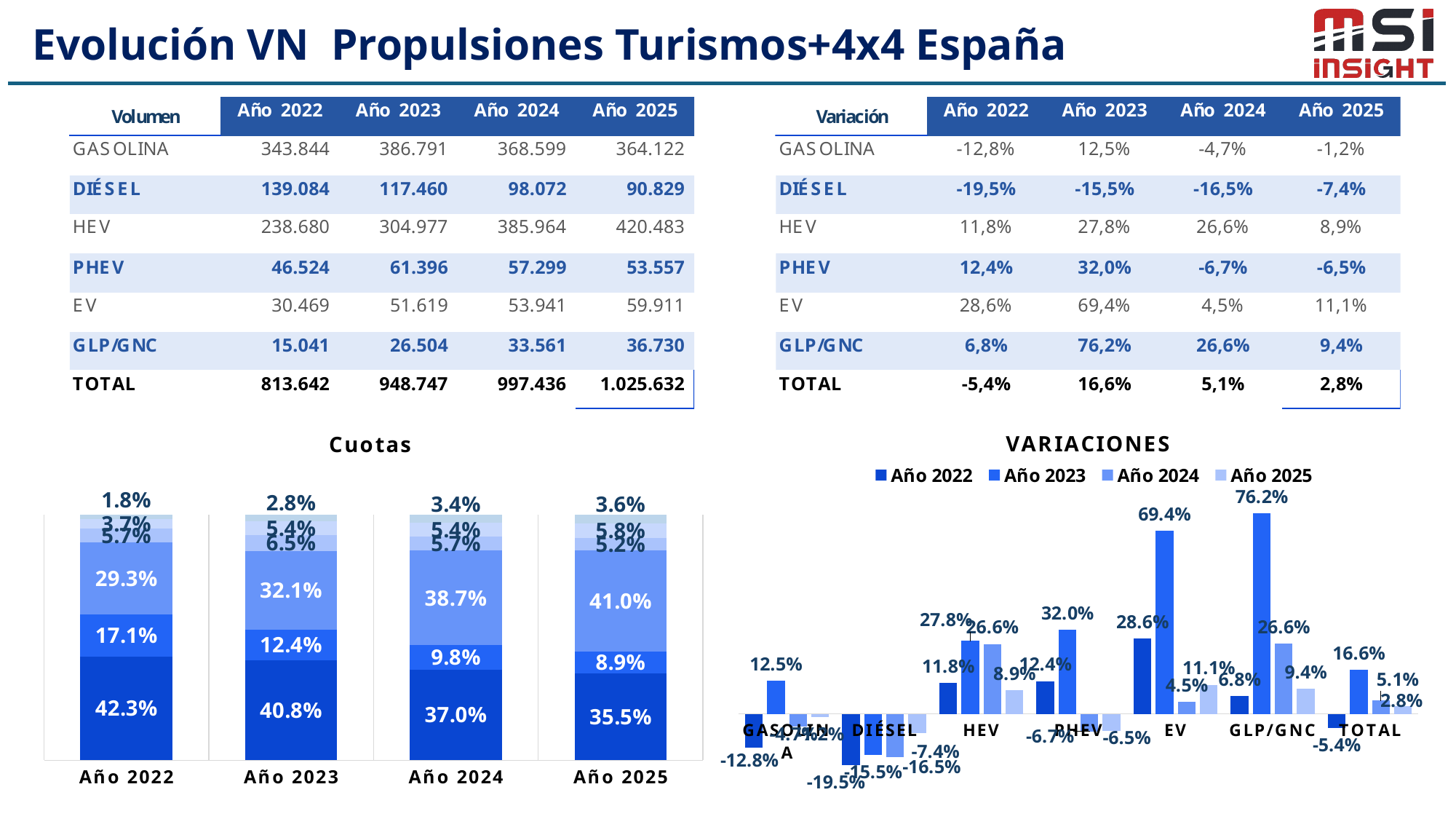
In the Cuotas chart, what is the value of the bottom segment of the Año 2025 bar? 35.5% What kind of chart is the VARIACIONES chart? Bar chart In the VARIACIONES chart, what is the value for GLP/GNC in Año 2023? 76.2% In the Cuotas chart, does the bottom segment of the bars rise or fall from Año 2022 to Año 2025? Fall In the Cuotas chart, what is the difference between the bottom segment of the Año 2022 bar and the bottom segment of the Año 2025 bar? 6.8 percentage points How many categories are shown on the x axis of the VARIACIONES chart? 7 In the VARIACIONES chart, which is larger: EV in Año 2023 or GLP/GNC in Año 2023? GLP/GNC in Año 2023 In the VARIACIONES chart, how many series does the legend list? 4 In the VARIACIONES chart, which category and year has the highest value? GLP/GNC, Año 2023 In the VARIACIONES chart, what is the value for EV in Año 2023? 69.4% How many stacked bars are shown in the Cuotas chart? 4 In the VARIACIONES chart, which category and year has the lowest value? DIÉSEL, Año 2022